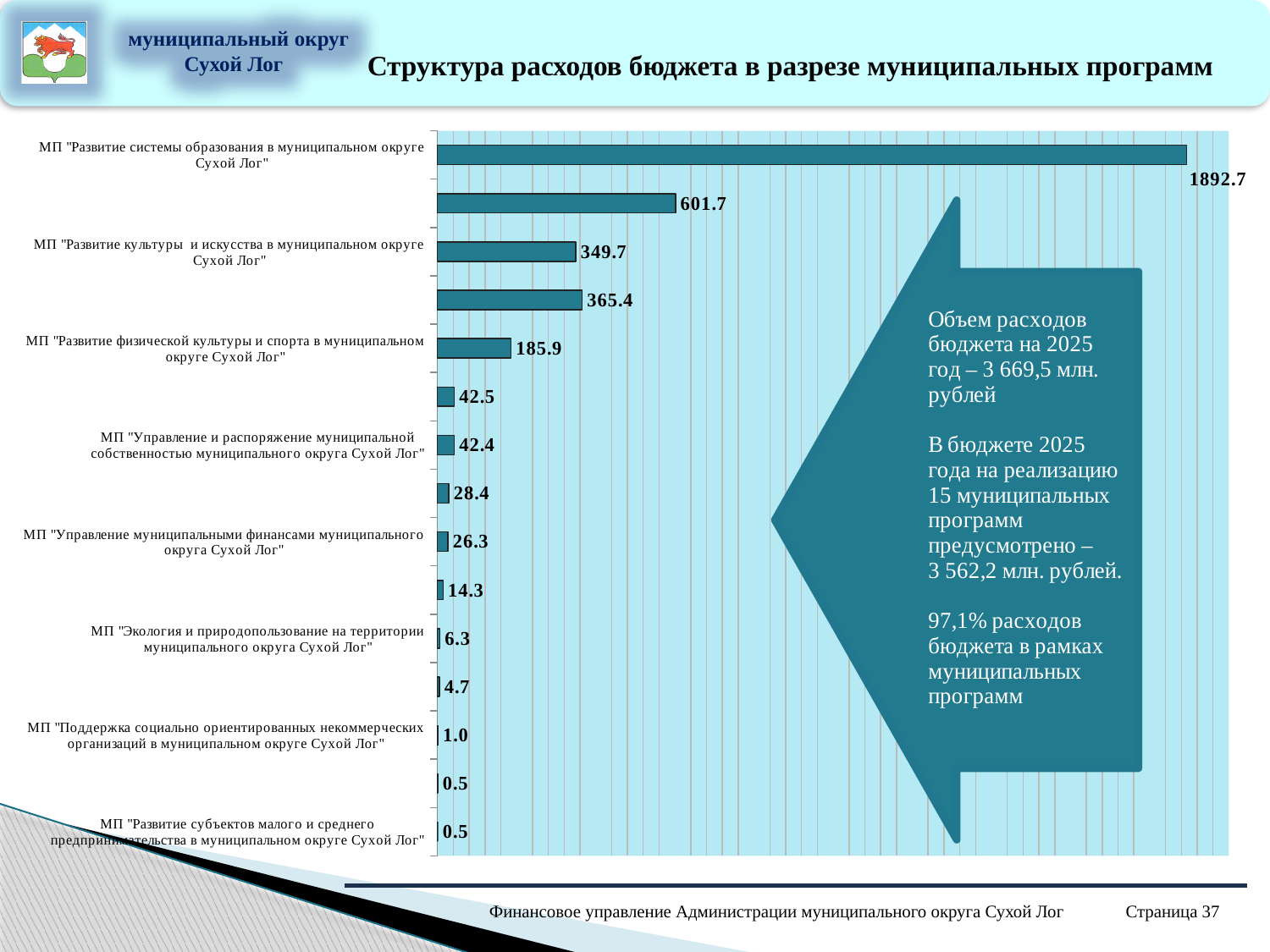
What is the value for МП "Развитие системы образования в муниципальном округе Сухой Лог"? 1892.7 How many bars are plotted in the chart? 15 Which program has the highest value in the chart? МП "Развитие системы образования в муниципальном округе Сухой Лог" What is the value for МП "Развитие культуры и искусства в муниципальном округе Сухой Лог"? 349.7 What is the difference between the values for МП "Развитие культуры и искусства" and МП "Развитие физической культуры и спорта"? 163.8 What is the value for МП "Развитие физической культуры и спорта в муниципальном округе Сухой Лог"? 185.9 What type of chart is shown on the slide? bar chart What is the title of the slide containing the chart? Структура расходов бюджета в разрезе муниципальных программ What is the value for МП "Экология и природопользование на территории муниципального округа Сухой Лог"? 6.3 What is the value for МП "Поддержка социально ориентированных некоммерческих организаций в муниципальном округе Сухой Лог"? 1.0 What is the value for МП "Управление и распоряжение муниципальной собственностью муниципального округа Сухой Лог"? 42.4 Which is larger: the value for МП "Управление муниципальными финансами" or the value for МП "Экология и природопользование"? МП "Управление муниципальными финансами"